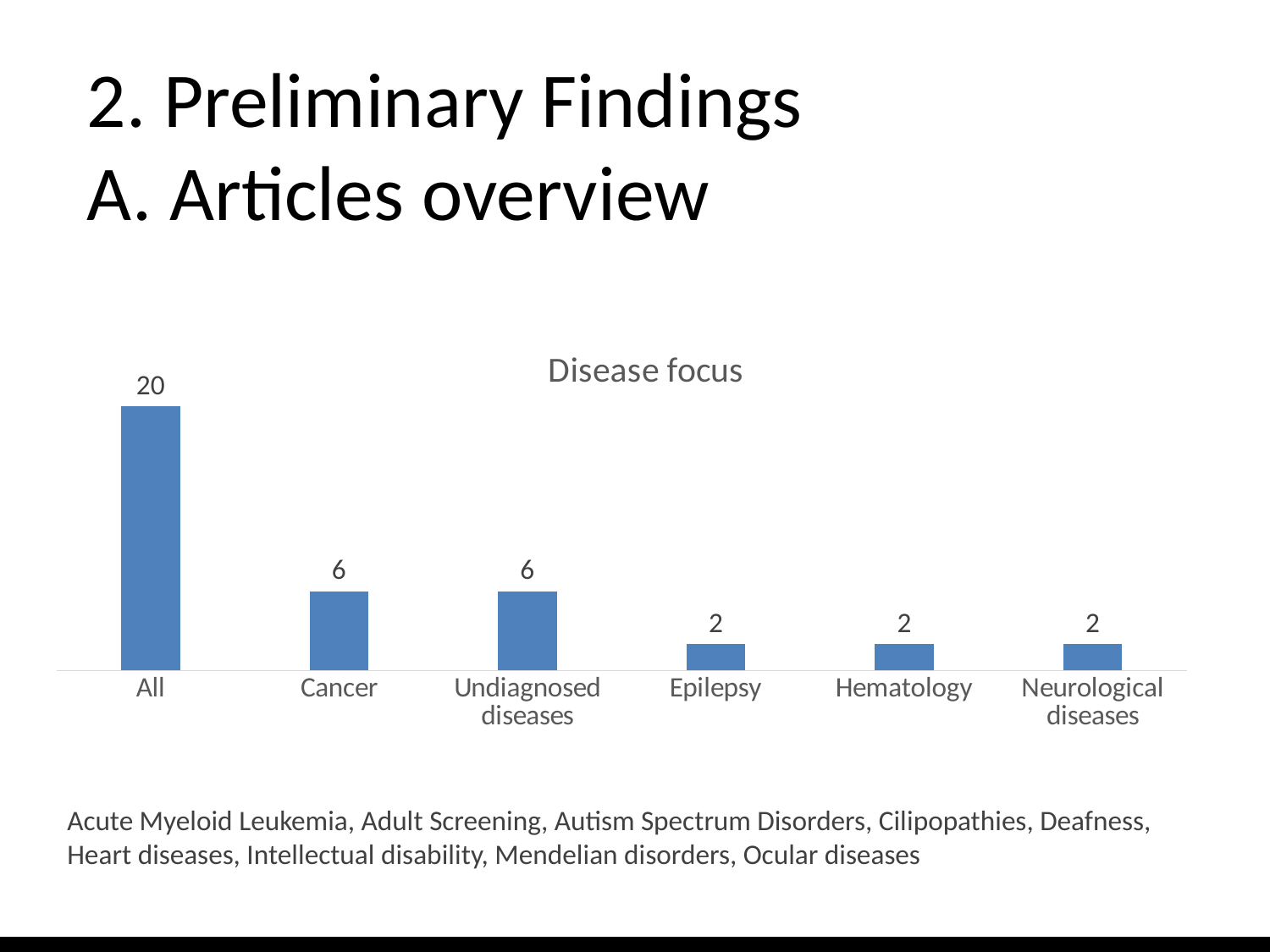
What is the value for Epilepsy in the Disease focus chart? 2 What is the difference between the values for All and Cancer? 14 What is the difference between the values for Cancer and Hematology? 4 How many categories are shown in the Disease focus chart? 6 What is the title of the chart on the slide? Disease focus Which category has the highest value in the Disease focus chart? All What kind of chart is shown on the slide? Bar chart Which is larger, the value for Undiagnosed diseases or the value for Neurological diseases? Undiagnosed diseases Do the values generally rise or fall from left to right across the categories? Fall What is the value for Cancer in the Disease focus chart? 6 What is the value for All in the Disease focus chart? 20 What is the value for Undiagnosed diseases in the Disease focus chart? 6